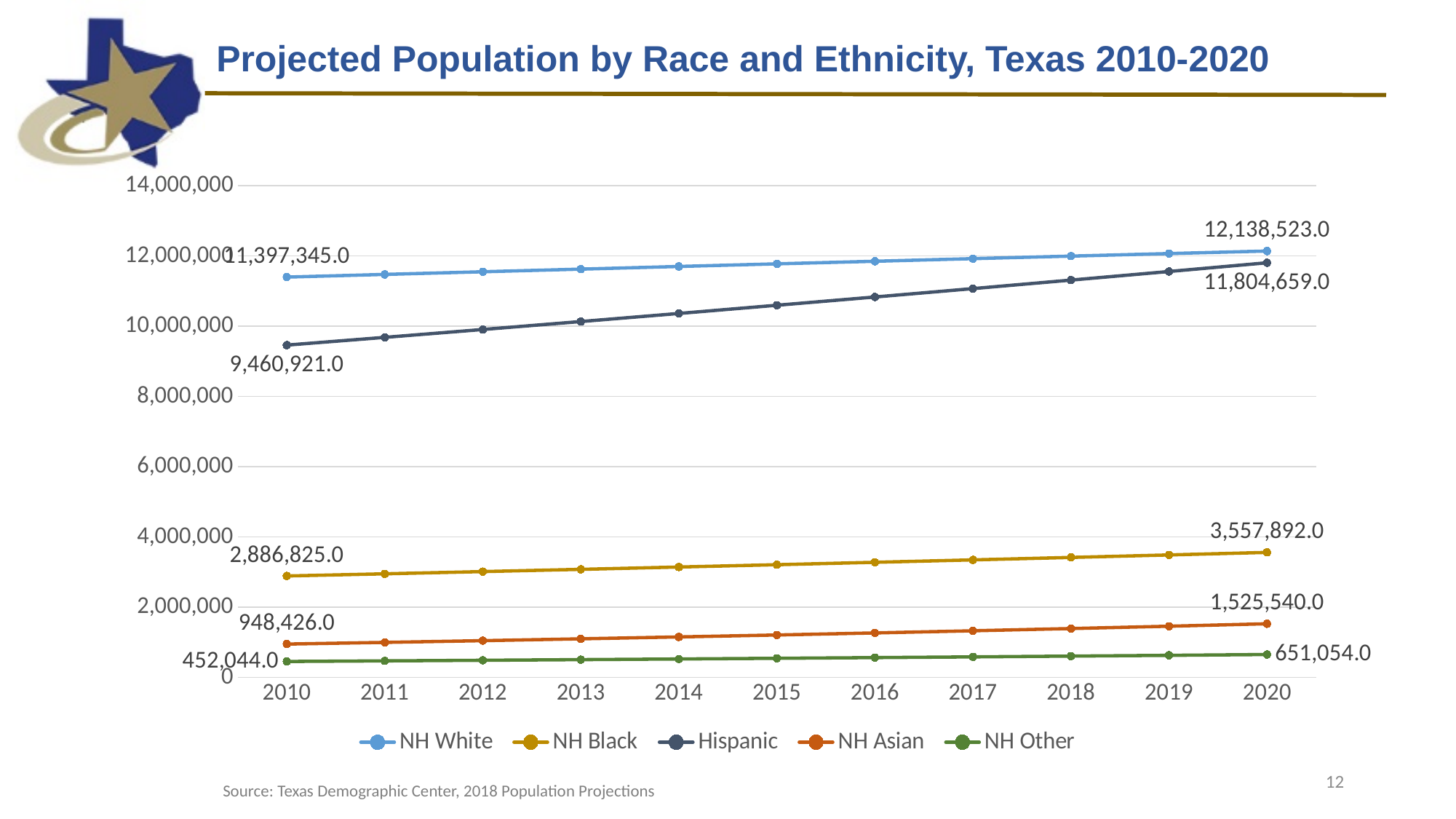
Is the Hispanic population in 2015 greater or less than 10,000,000? greater Which group has the highest projected population in 2010? NH White By how much does the Hispanic population increase from 2010 to 2020? 2,343,738.0 What type of chart is shown on the slide? line chart What is the projected NH White population in 2020? 12,138,523.0 What is the projected NH Asian population in 2020? 1,525,540.0 Does the NH Black population rise or fall from 2010 to 2020? rise Which group has the lowest projected population in 2020? NH Other How many series does the legend list? 5 What is the projected Hispanic population in 2010? 9,460,921.0 How many years are shown on the x axis? 11 What is the projected NH Other population in 2010? 452,044.0